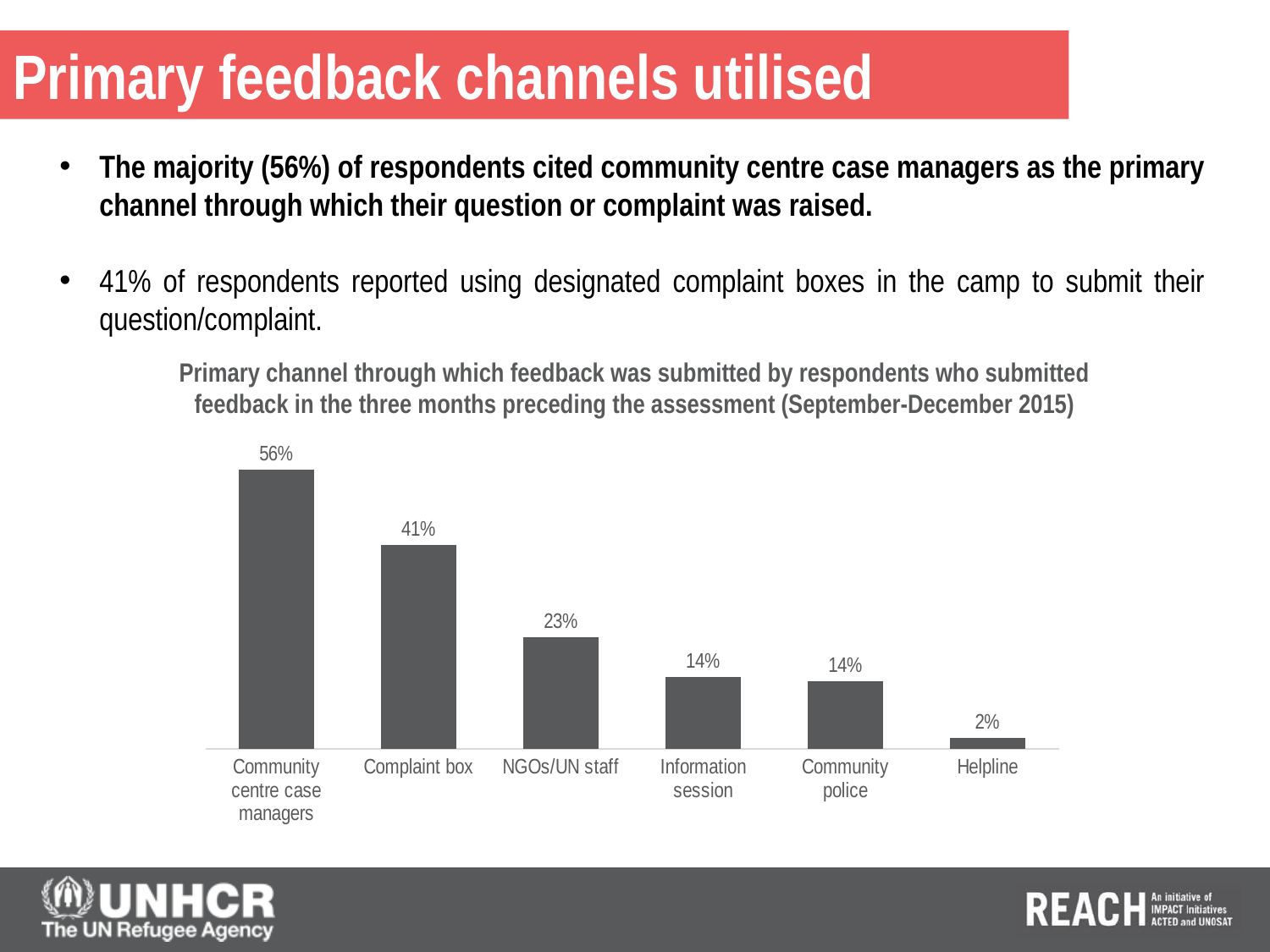
What is the difference between the values for Community centre case managers and Complaint box? 15% Which is larger, the value for Complaint box or the value for NGOs/UN staff? Complaint box What percentage of respondents cited community centre case managers as their primary feedback channel? 56% Which feedback channel has the lowest value? Helpline How many feedback channels are shown in the chart? 6 What is the value shown for Helpline? 2% Which feedback channel has the highest value? Community centre case managers What is the difference between the values for NGOs/UN staff and Helpline? 21% What is the value shown for Complaint box? 41% What is the value shown for NGOs/UN staff? 23% Do the values rise or fall moving from left to right across the chart? Fall What kind of chart is shown on the slide? Bar chart